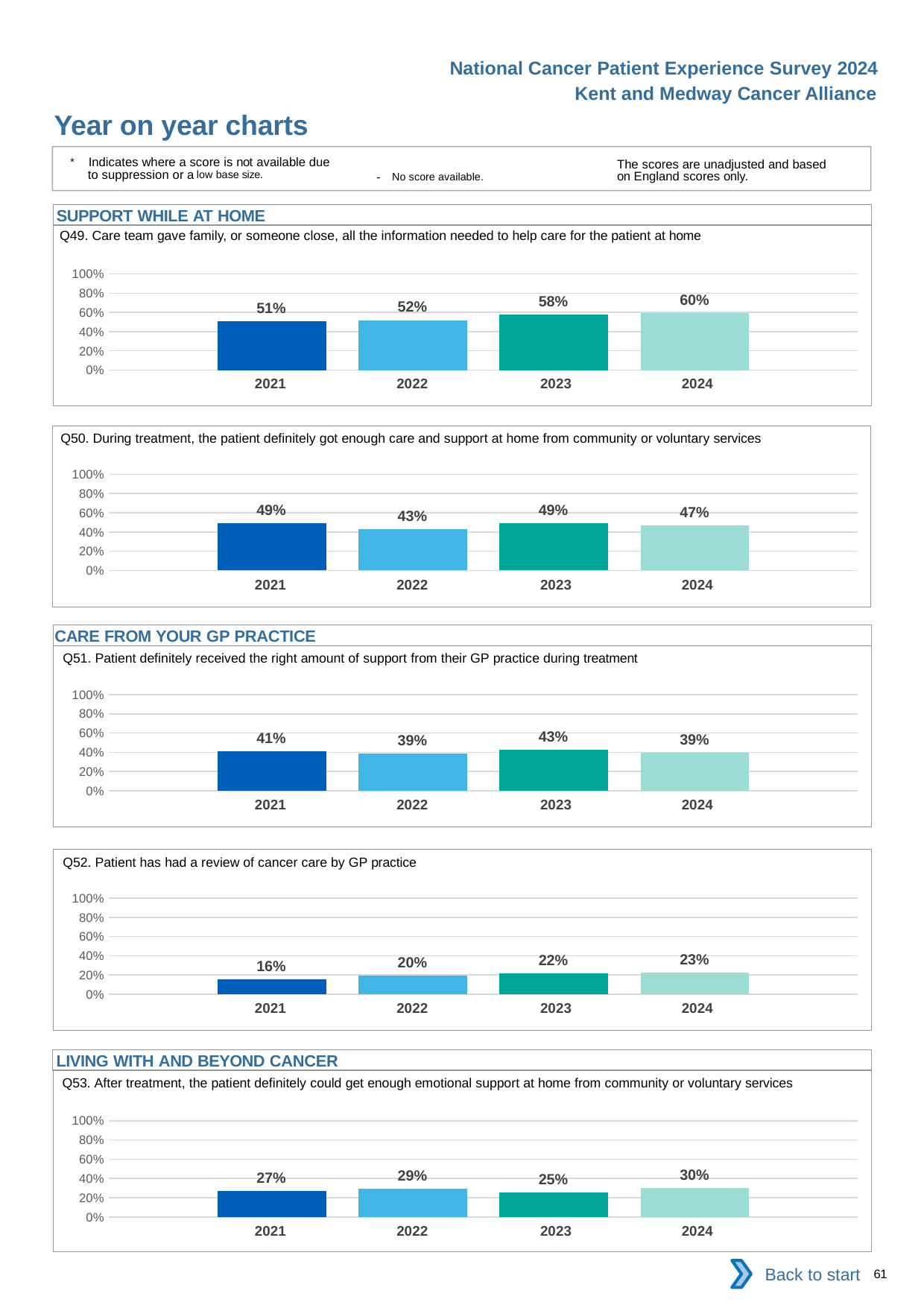
In the Q53 chart, what is the value for 2024? 30% In the Q50 chart, what is the difference between the 2021 and 2022 values? 6% In the Q49 chart, what is the value for 2024? 60% In the Q51 chart, which year has the highest value? 2023 In the Q53 chart, which is larger, the value for 2022 or the value for 2023? 2022 In the Q51 chart, what is the value for 2021? 41% In the Q52 chart, do the values rise or fall from 2021 to 2024? rise How many years are shown in the Q49 chart? 4 In the Q52 chart, what is the difference between the 2024 and 2021 values? 7% In the Q49 chart, which year has the lowest value? 2021 In the Q50 chart, what is the value for 2022? 43% What kind of chart is the Q52 chart? bar chart